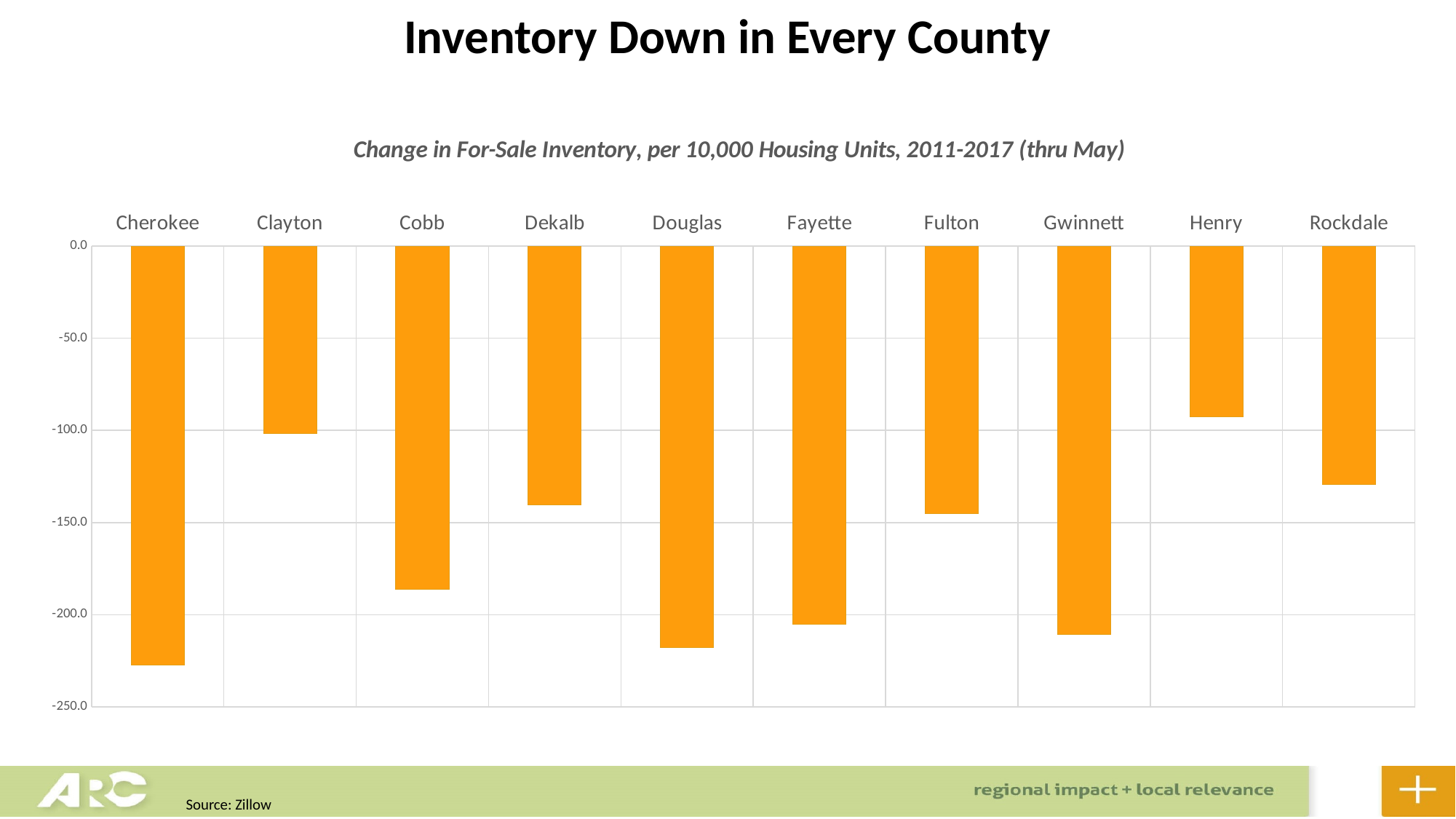
How many counties are shown in the chart? 10 Is the value for Cherokee greater or less than -200.0? less What kind of chart is shown on the slide? bar chart Which county shows a larger decline in inventory, Cobb or Dekalb? Cobb Is the value for Gwinnett greater or less than -200.0? less Is the value for Cobb greater or less than -150.0? less Which county shows a larger decline in inventory, Douglas or Fulton? Douglas What is the source cited for the chart data? Zillow Which county shows the largest decline in for-sale inventory (the most negative value)? Cherokee Which county shows the smallest decline in for-sale inventory (the least negative value)? Henry